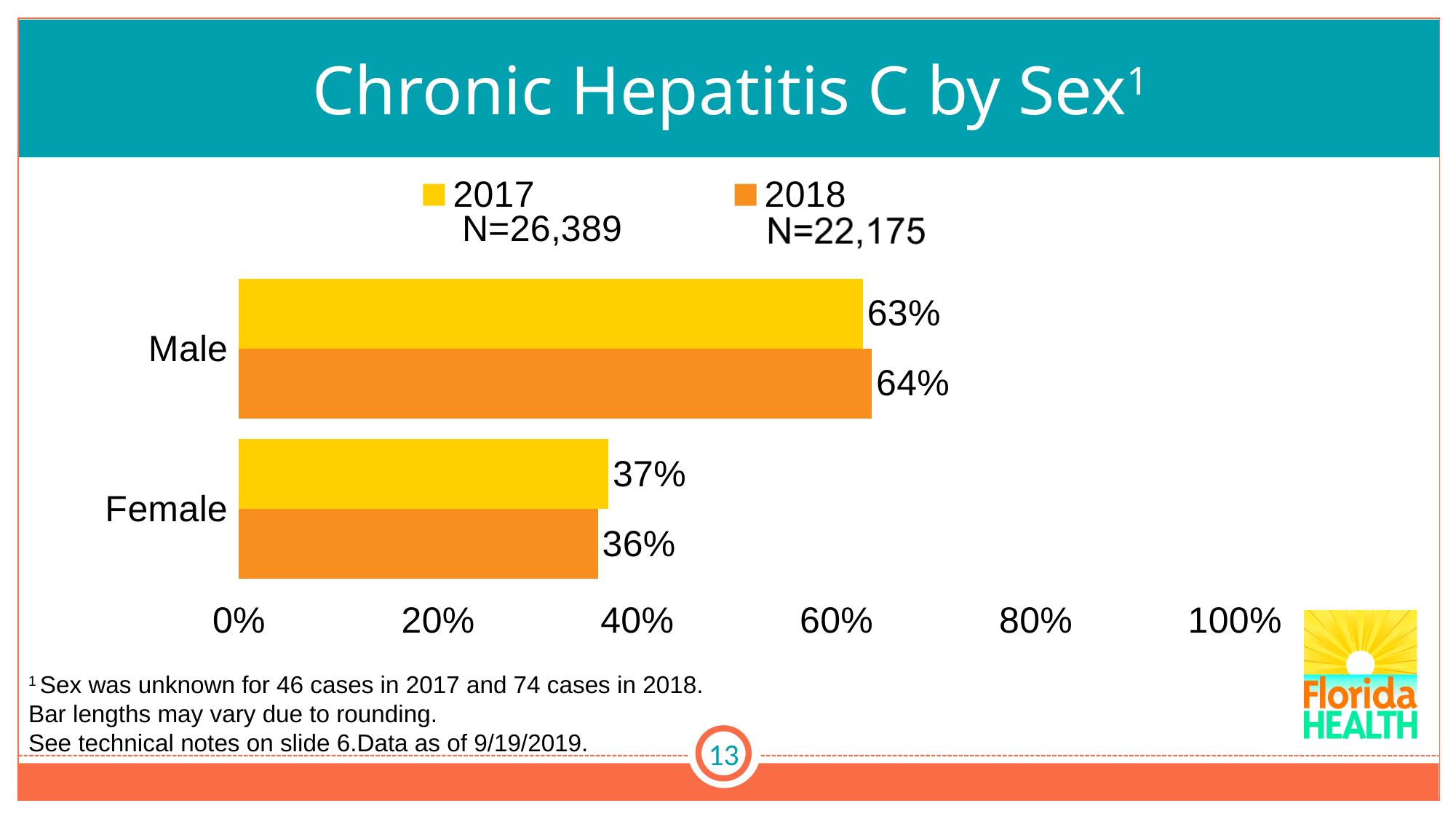
Which category has the highest value in the 2018 series? Male What is the value for Female in the 2017 series? 37% What is the difference between the Male and Female values in 2017? 26% What is the N value shown in the legend for 2018? N=22,175 What is the value for Male in the 2018 series? 64% Which is larger: the Male value in 2017 or the Female value in 2017? Male value in 2017 Which category has the lowest value in the 2017 series? Female What kind of chart is shown on the slide? Bar chart How many series does the legend list? 2 What percentage of chronic hepatitis C cases were male in 2017? 63% How many categories are shown on the chart? 2 What percentage of chronic hepatitis C cases were female in 2018? 36%